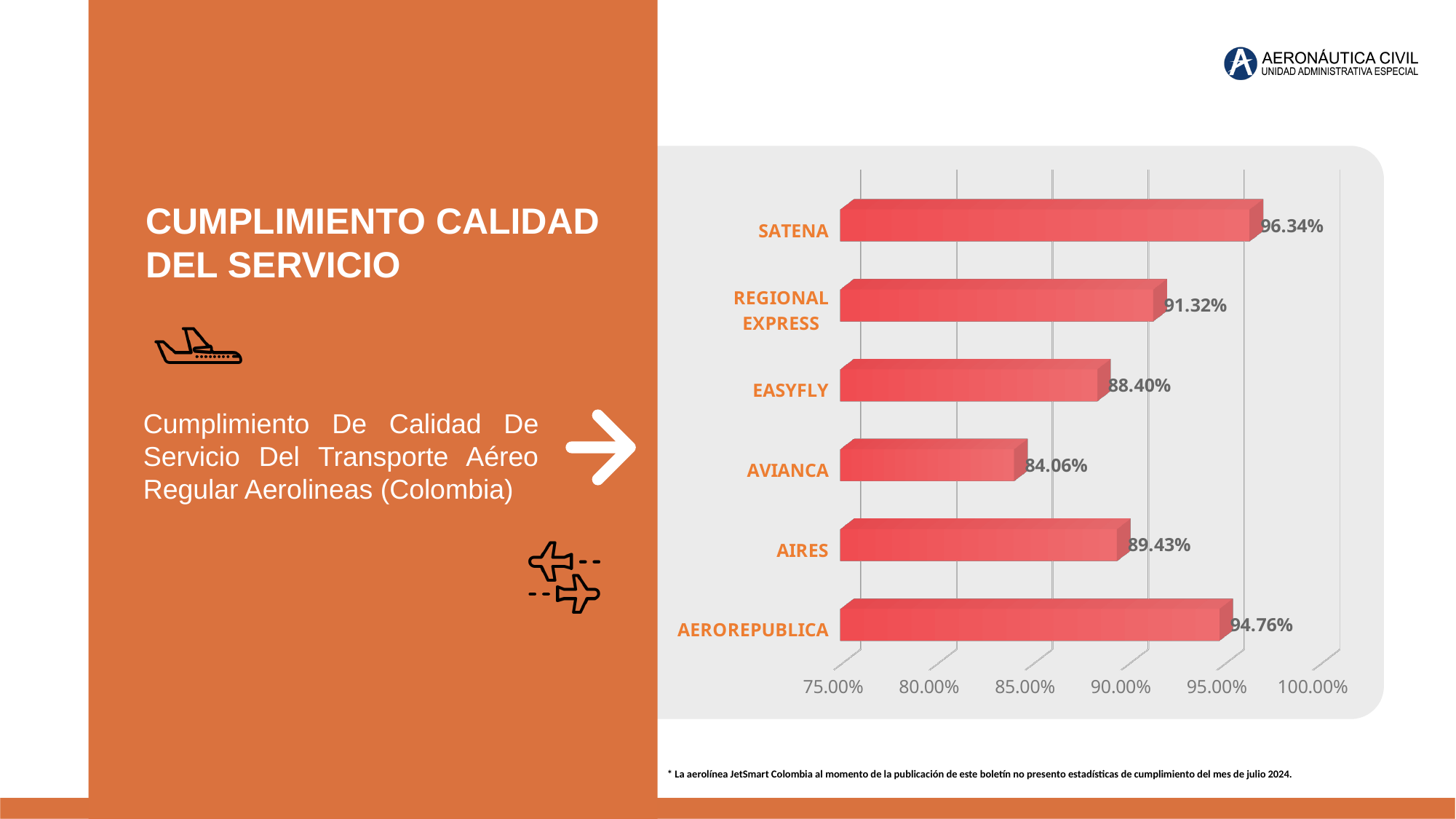
What is the value for REGIONAL EXPRESS? 91.32% What is the difference between the values for AIRES and EASYFLY? 1.03% Which airline has the highest value? SATENA What is the value for SATENA? 96.34% What is the difference between the values for SATENA and AVIANCA? 12.28% Which airline has the lowest value? AVIANCA Is the value for EASYFLY greater or less than 90.00%? less What kind of chart is shown on the slide? bar chart Which is larger, the value for AEROREPUBLICA or the value for REGIONAL EXPRESS? AEROREPUBLICA What is the value for AVIANCA? 84.06% What is the value for AEROREPUBLICA? 94.76% How many airlines are shown in the chart? 6